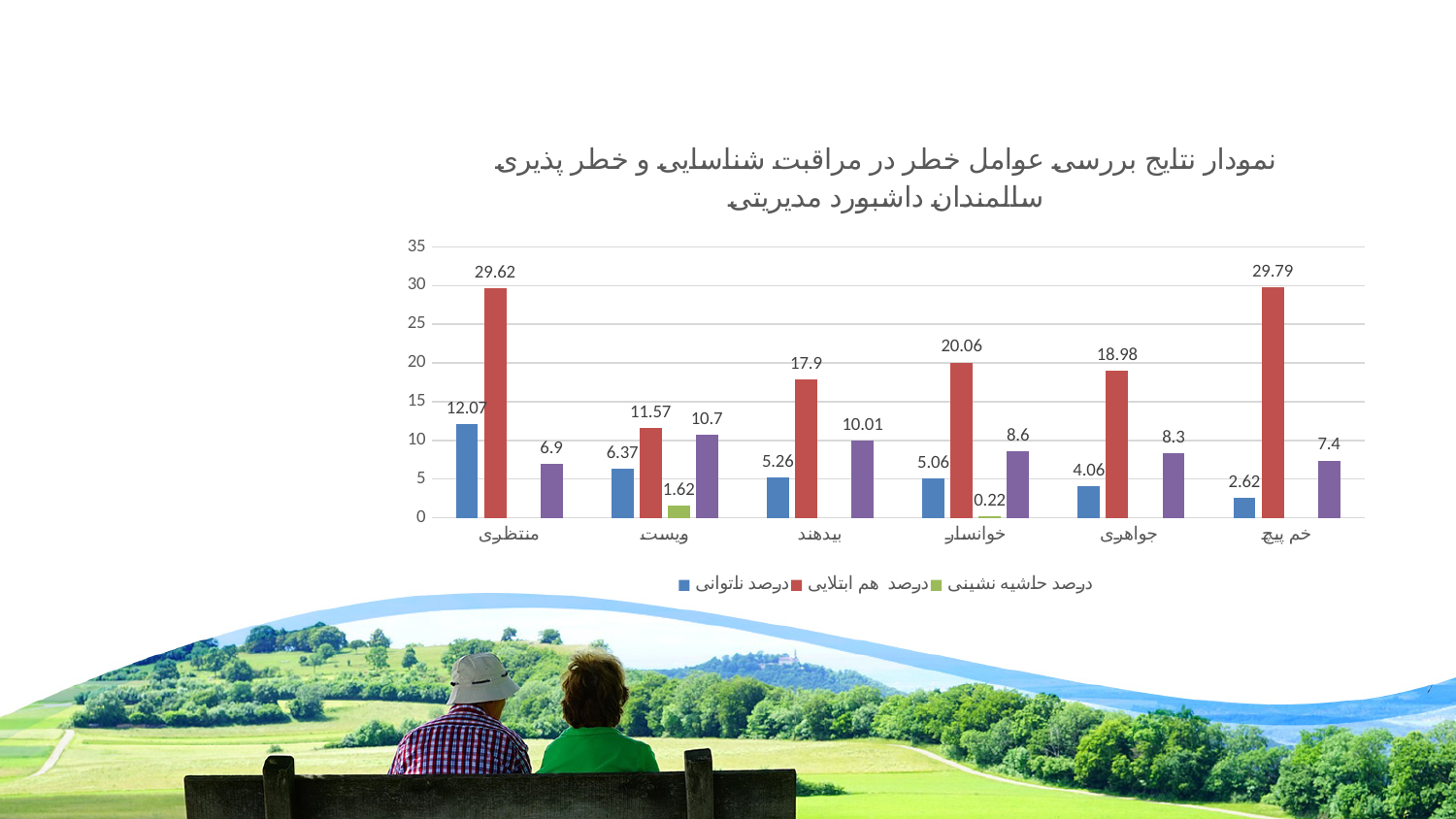
What is the value of the purple bar for بیدهند? 10.01 Which is larger: the درصد ناتوانی value for ویست or for بیدهند? ویست How many categories are shown on the x axis of the chart? 6 Which category has the highest درصد هم ابتلایی (red bar)? خم پیچ What is the value of درصد ناتوانی (blue bar) for منتظری? 12.07 How many series does the chart legend list? 3 What is the value of درصد هم ابتلایی (red bar) for خم پیچ? 29.79 What type of chart is shown on the slide? bar chart What is the value of درصد حاشیه نشینی (green bar) for ویست? 1.62 Does the درصد ناتوانی (blue bar) rise or fall going from منتظری to خم پیچ? fall Which category has the lowest درصد ناتوانی (blue bar)? خم پیچ What is the difference between the درصد هم ابتلایی values for خم پیچ and منتظری? 0.17